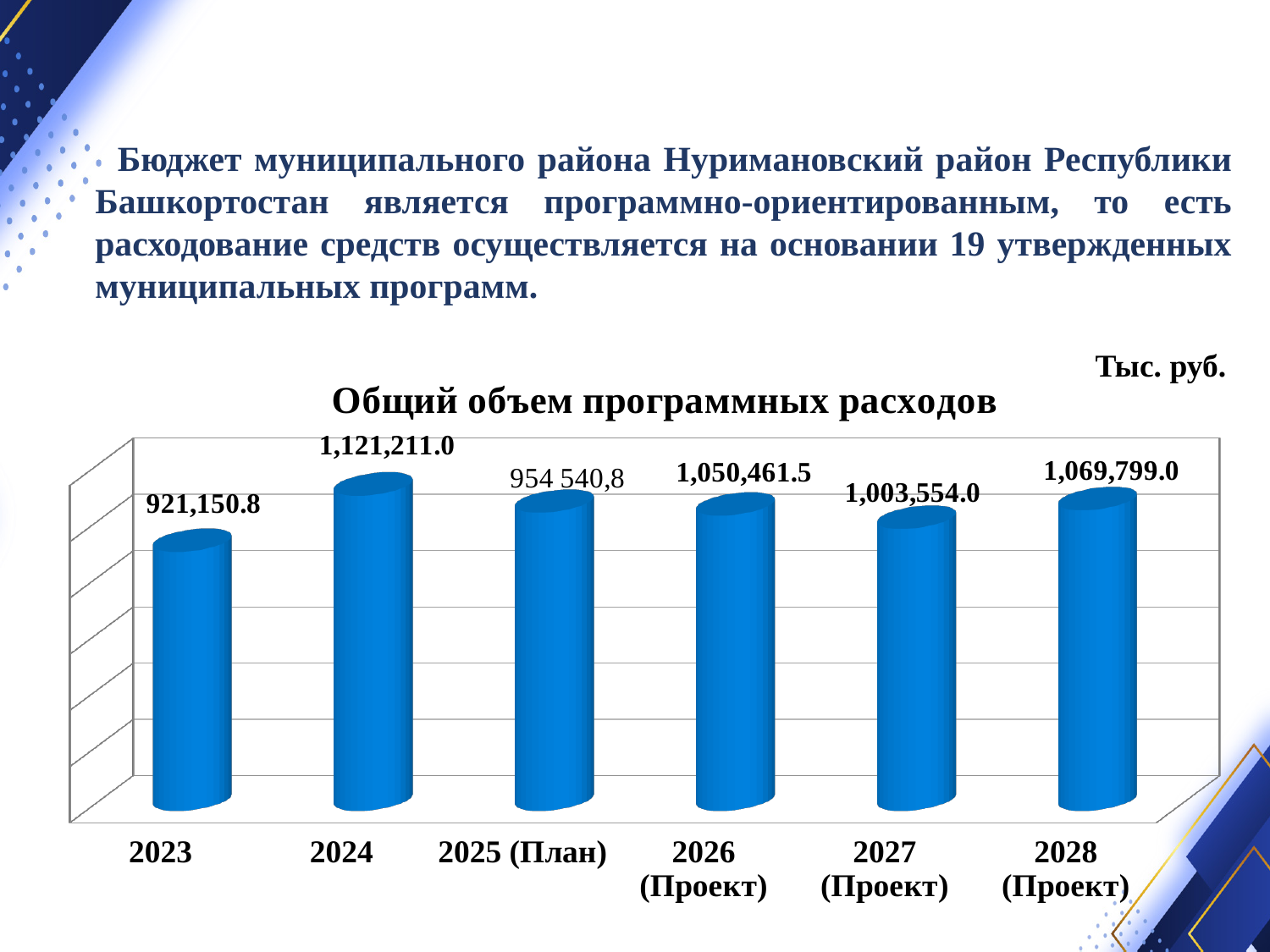
What is the value for 2027 (Проект) in the chart? 1,003,554.0 Which year has the lowest value in the chart? 2023 How many categories (years) are shown in the chart? 6 What kind of chart is shown on the slide? Bar chart Which is larger, the value for 2026 (Проект) or the value for 2027 (Проект)? 2026 (Проект) What is the difference between the values for 2028 (Проект) and 2027 (Проект)? 66,245.0 What is the value for 2024 in the chart? 1,121,211.0 What is the value for 2025 (План) in the chart? 954 540,8 What is the difference between the values for 2024 and 2023? 200,060.2 What unit of measurement is indicated for the chart? Тыс. руб. What is the value for 2023 in the chart 'Общий объем программных расходов'? 921,150.8 Which year has the highest value in the chart? 2024